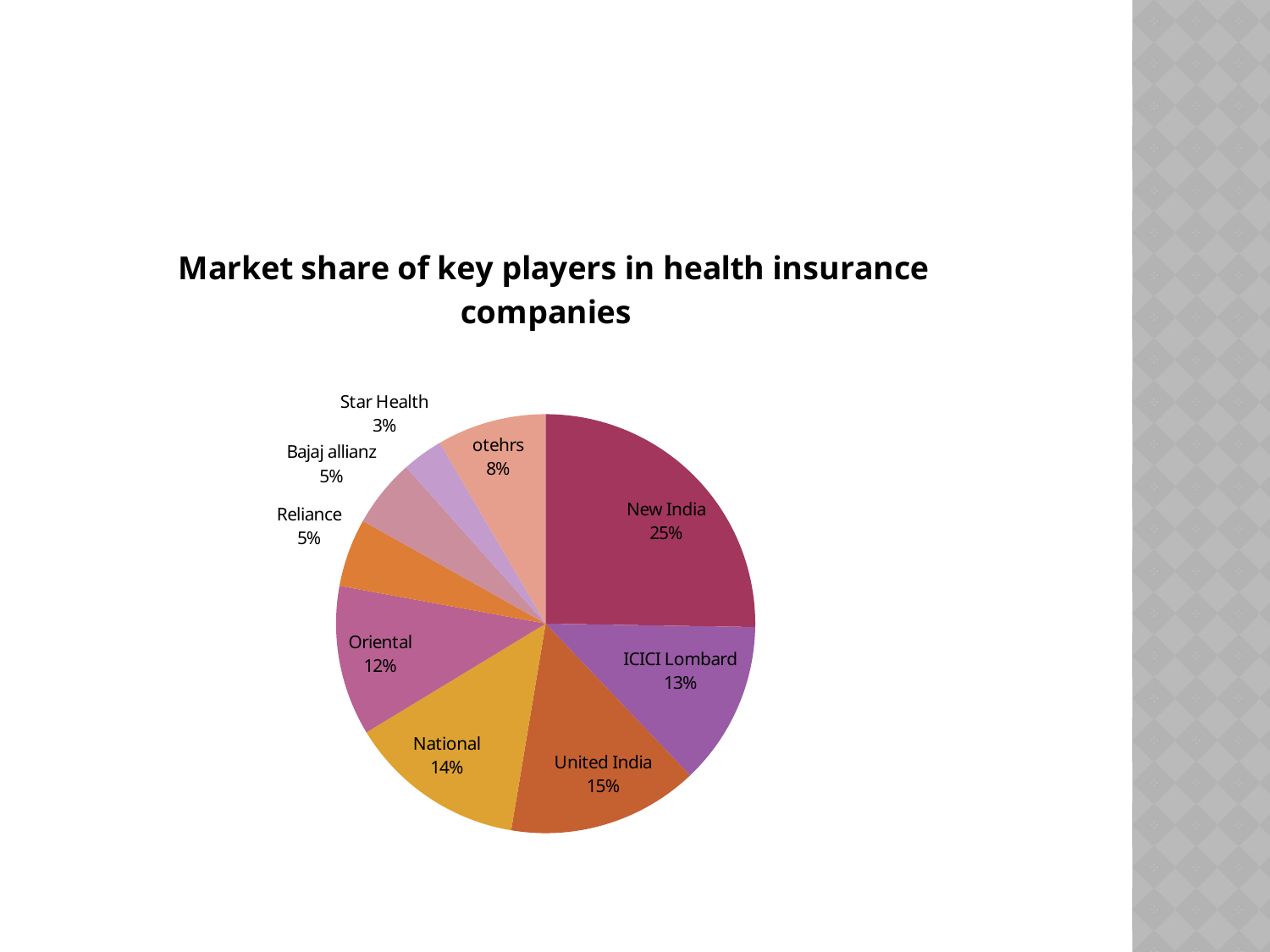
What is the market share of ICICI Lombard? 13% What is the combined market share of Reliance and Bajaj allianz? 10% How many slices does the pie chart have? 9 What is the difference in market share between New India and United India? 10% What is the market share of Oriental? 12% Which has a larger market share, National or ICICI Lombard? National What kind of chart is shown on the slide? Pie chart Which company has the smallest market share? Star Health Which company has the largest market share? New India What is the market share of Star Health? 3% What is the title of the chart? Market share of key players in health insurance companies What is the market share of New India? 25%